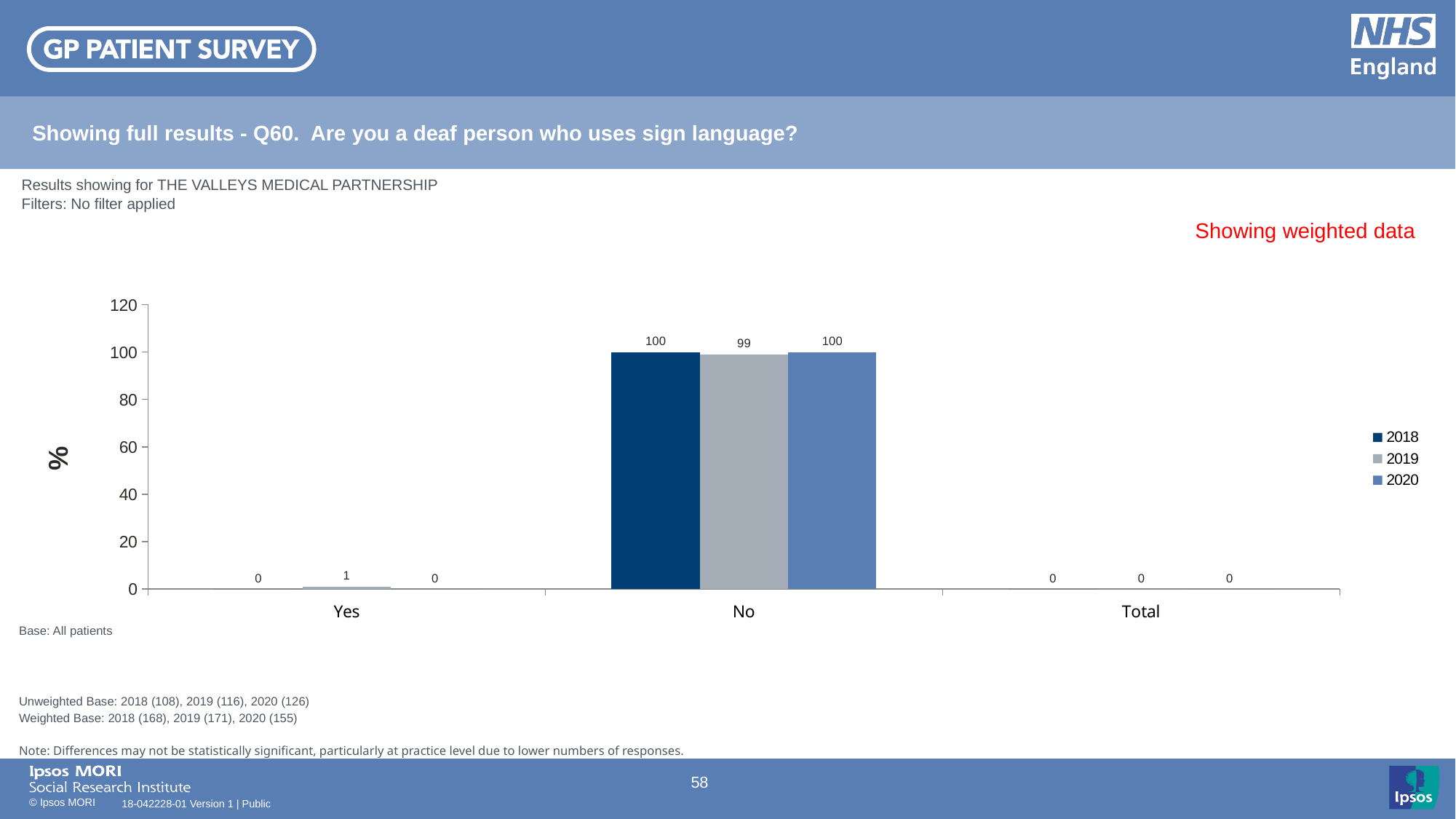
Which category has the highest value for 2018? No What is the value for 'No' in 2019? 99 How many categories are shown on the x axis? 3 What label is shown on the y axis? % Which is larger: the 'No' value for 2019 or the 'No' value for 2020? 2020 What is the value for 'No' in 2020? 100 What is the difference between the 'No' values for 2018 and 2019? 1 What is the value for 'Yes' in 2018? 0 What is the value for 'Yes' in 2019? 1 Is the value for 'No' in 2018 greater or less than 80? greater What kind of chart is shown on the slide? bar chart How many series does the legend list? 3